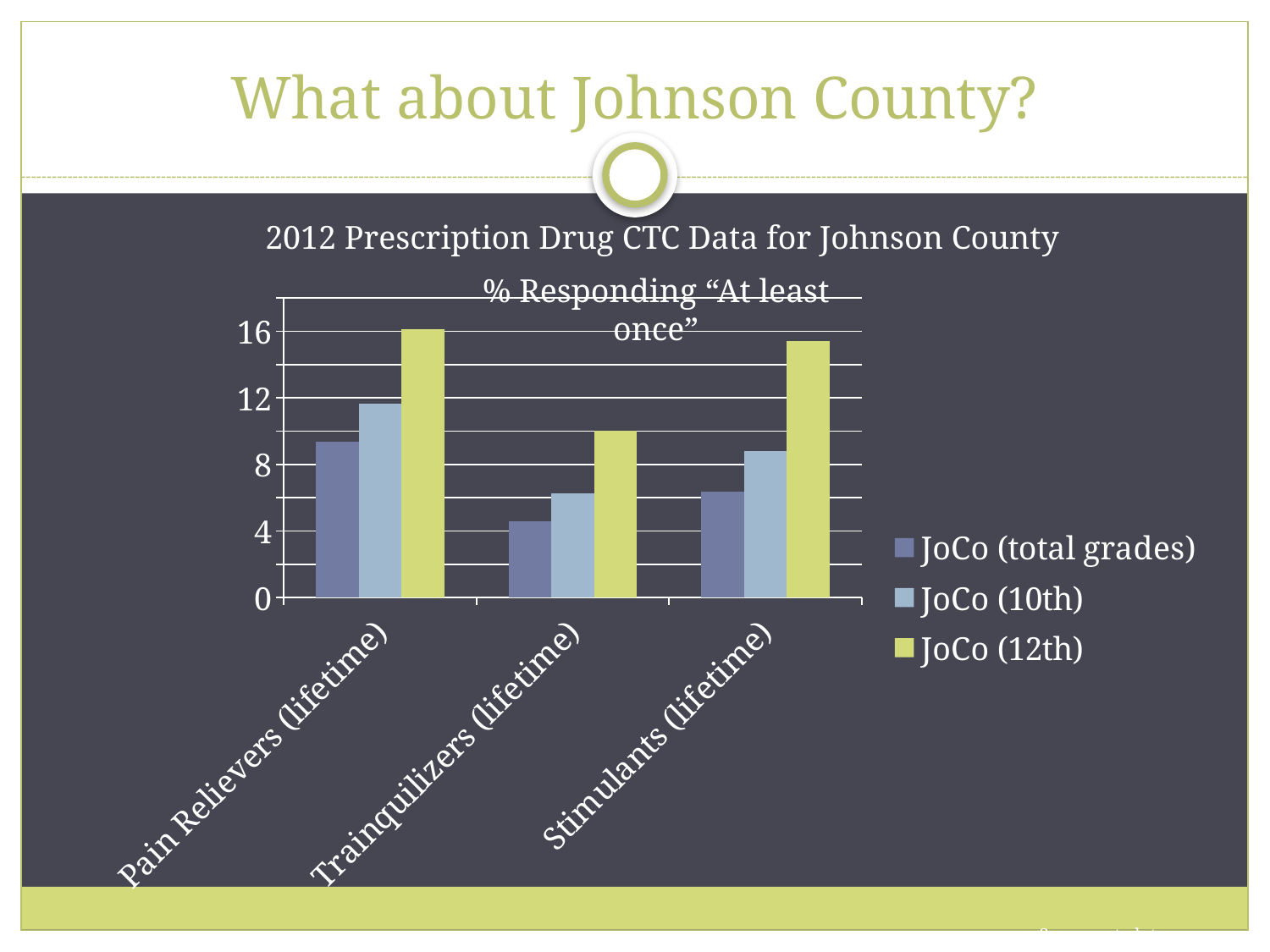
Is the JoCo (total grades) value for Tranquilizers (lifetime) greater or less than 8? less Is the JoCo (12th) value for Stimulants (lifetime) greater or less than 12? greater Which category has the lowest JoCo (12th) value? Tranquilizers (lifetime) Which series has the highest value for Pain Relievers (lifetime)? JoCo (12th) How many categories are shown on the x axis of the chart? 3 Which is larger: the JoCo (10th) value for Pain Relievers (lifetime) or for Stimulants (lifetime)? Pain Relievers (lifetime) How many series does the chart's legend list? 3 Is the JoCo (12th) value for Pain Relievers (lifetime) greater or less than 12? greater Which series is shown in yellow-green in the chart? JoCo (12th) What kind of chart is shown on the slide? bar chart What is the title of the chart? 2012 Prescription Drug CTC Data for Johnson County